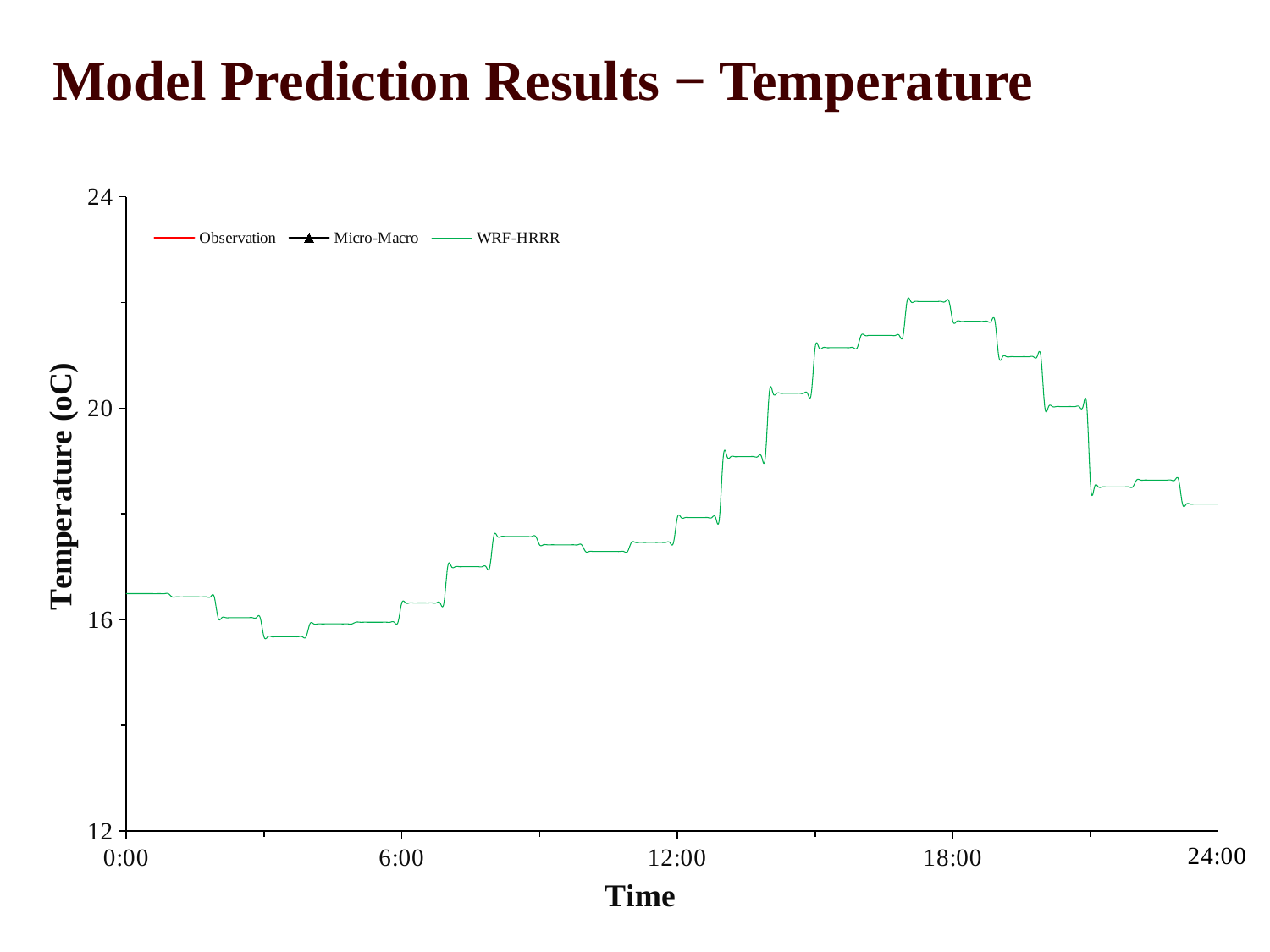
Which is higher, the temperature at 18:00 or the temperature at 6:00? 18:00 Is the temperature at 18:00 greater or less than 20? greater What kind of chart is shown on the slide? line chart Does the temperature rise or fall between 18:00 and 24:00? fall How many series does the chart legend list? 3 Is the peak temperature on the chart greater or less than 20? greater How many time labels are shown on the x axis? 5 Is the temperature at 24:00 greater or less than 16? greater What is the title of the slide containing the temperature chart? Model Prediction Results − Temperature Does the temperature rise or fall between 6:00 and 18:00? rise What is the label of the y axis of the chart? Temperature (oC)